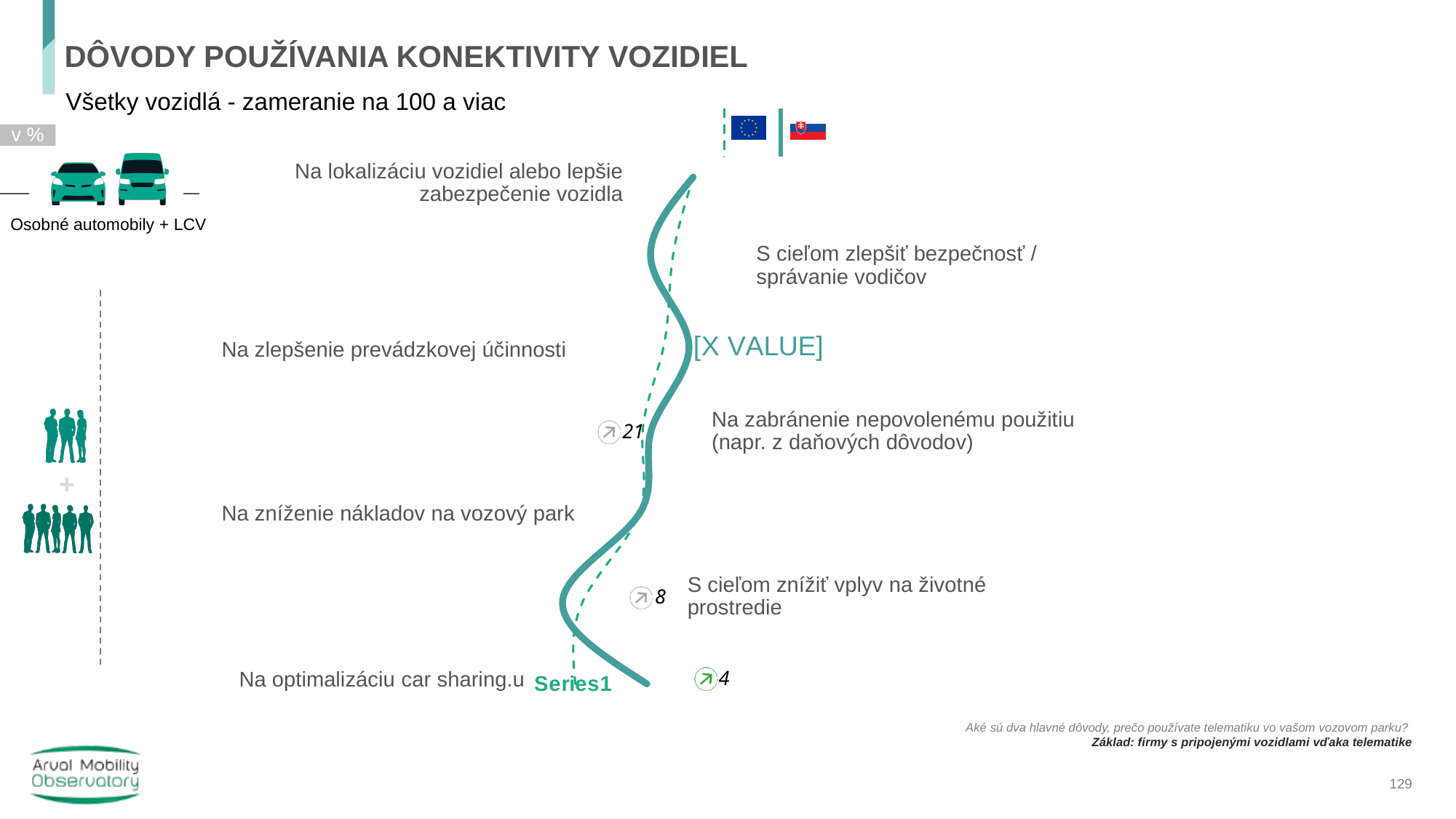
What is the difference between the printed values for 'Na zabránenie nepovolenému použitiu' (21) and 'S cieľom znížiť vplyv na životné prostredie' (8)? 13 What value is printed next to the category 'S cieľom znížiť vplyv na životné prostredie'? 8 What is the difference between the printed values for 'S cieľom znížiť vplyv na životné prostredie' (8) and 'Na optimalizáciu car sharing.u' (4)? 4 What is the title of the slide containing the chart? DÔVODY POUŽÍVANIA KONEKTIVITY VOZIDIEL What series name is shown as a label on the chart? Series1 Which has the larger printed value: 'Na zabránenie nepovolenému použitiu' or 'S cieľom znížiť vplyv na životné prostredie'? Na zabránenie nepovolenému použitiu What kind of chart is shown on the slide? line chart What value is printed next to the category 'Na optimalizáciu car sharing.u'? 4 What value is printed next to the category 'Na zabránenie nepovolenému použitiu (napr. z daňových dôvodov)'? 21 Which has the larger printed value: 'S cieľom znížiť vplyv na životné prostredie' or 'Na optimalizáciu car sharing.u'? S cieľom znížiť vplyv na životné prostredie